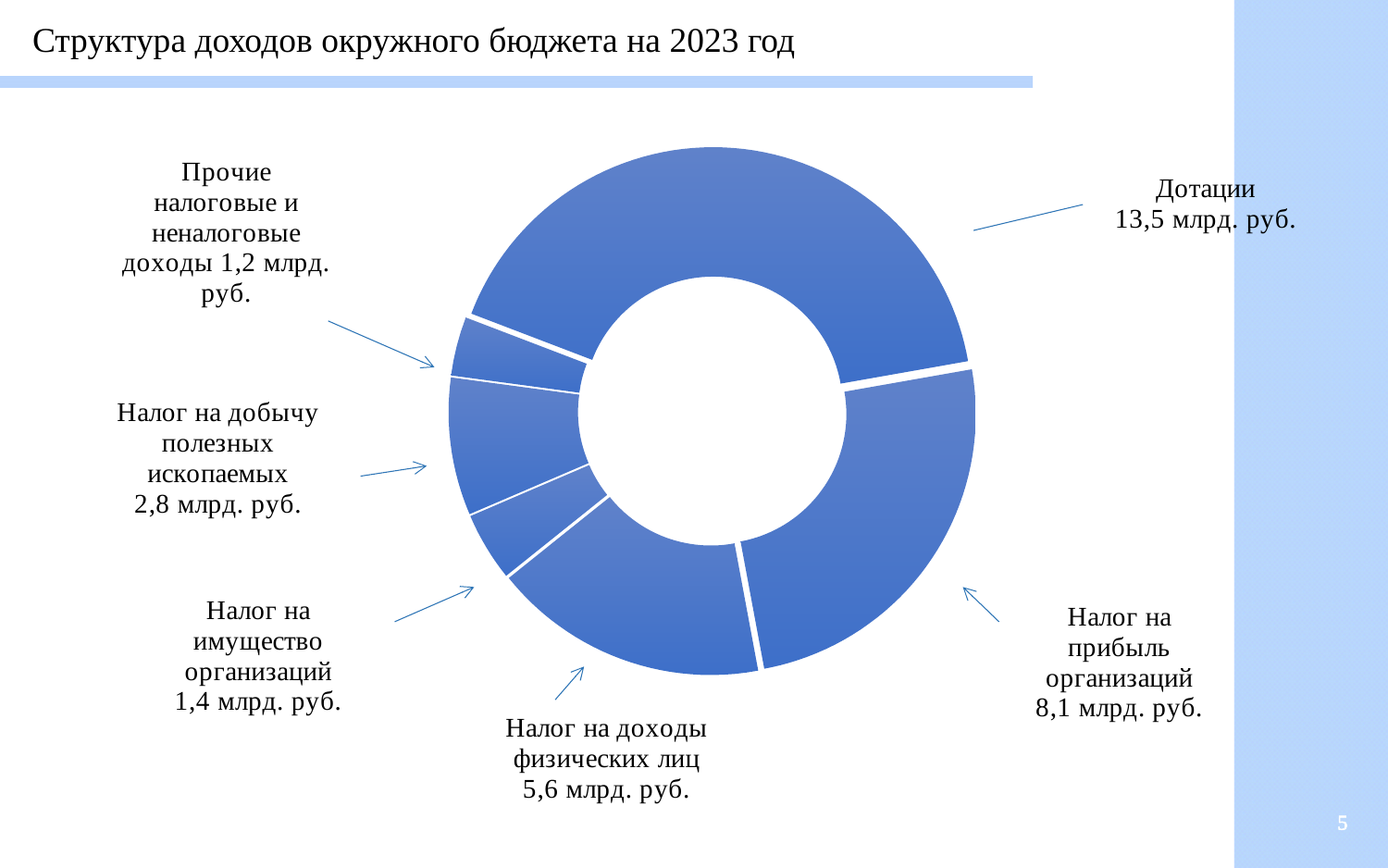
What is the difference between Дотации and Налог на прибыль организаций? 5,4 млрд. руб. What is the title of the slide? Структура доходов окружного бюджета на 2023 год Which is larger: Налог на доходы физических лиц or Налог на добычу полезных ископаемых? Налог на доходы физических лиц What type of chart is shown on the slide? Donut (pie) chart What is the value for Налог на добычу полезных ископаемых? 2,8 млрд. руб. What is the value for Налог на прибыль организаций? 8,1 млрд. руб. What is the value for Налог на доходы физических лиц? 5,6 млрд. руб. What is the difference between Налог на добычу полезных ископаемых and Налог на имущество организаций? 1,4 млрд. руб. Which category has the smallest value? Прочие налоговые и неналоговые доходы What is the value for Дотации? 13,5 млрд. руб. How many segments does the chart have? 6 Which category has the largest value? Дотации